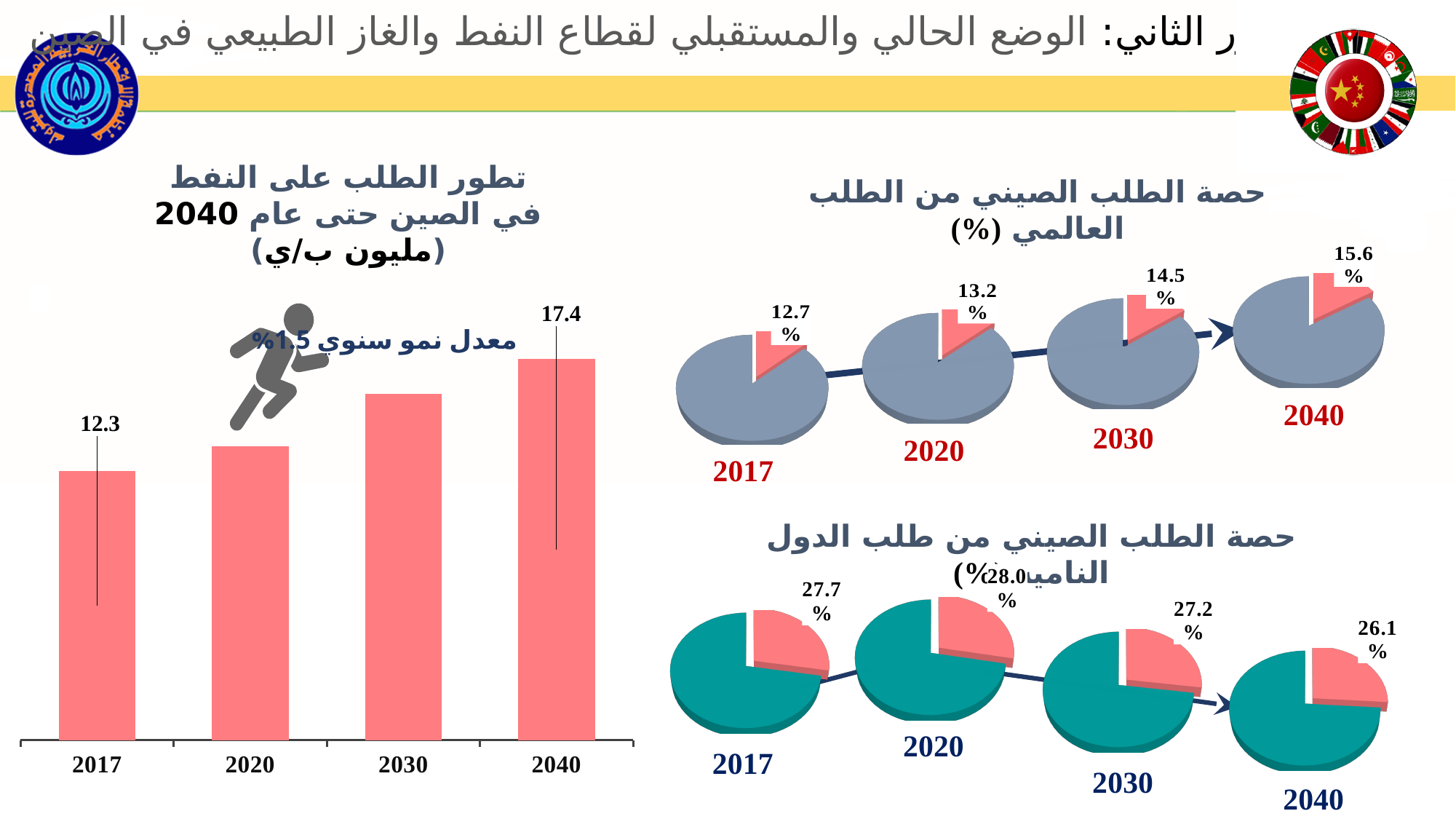
In the top-right chart (China's share of global demand), which year has the lowest share? 2017 What kind of chart is the chart on the left of the slide? bar chart In the bottom-right chart (China's share of developing countries' demand), which year has the highest share? 2020 In the bar chart on the left, what is the value for 2040? 17.4 In the bottom-right chart (China's share of developing countries' demand), what is the share shown for 2040? 26.1% In the bar chart on the left, which year has the highest bar? 2040 How many bars are in the bar chart on the left? 4 In the top-right chart (China's share of global demand), what is the share shown for 2030? 14.5% In the bar chart on the left, what is the value for 2017? 12.3 In the bottom-right chart, is the share for 2017 larger or smaller than the share for 2040? larger In the bar chart on the left, do the values rise or fall from 2017 to 2040? rise In the bar chart on the left, what is the difference between the 2040 value and the 2017 value? 5.1